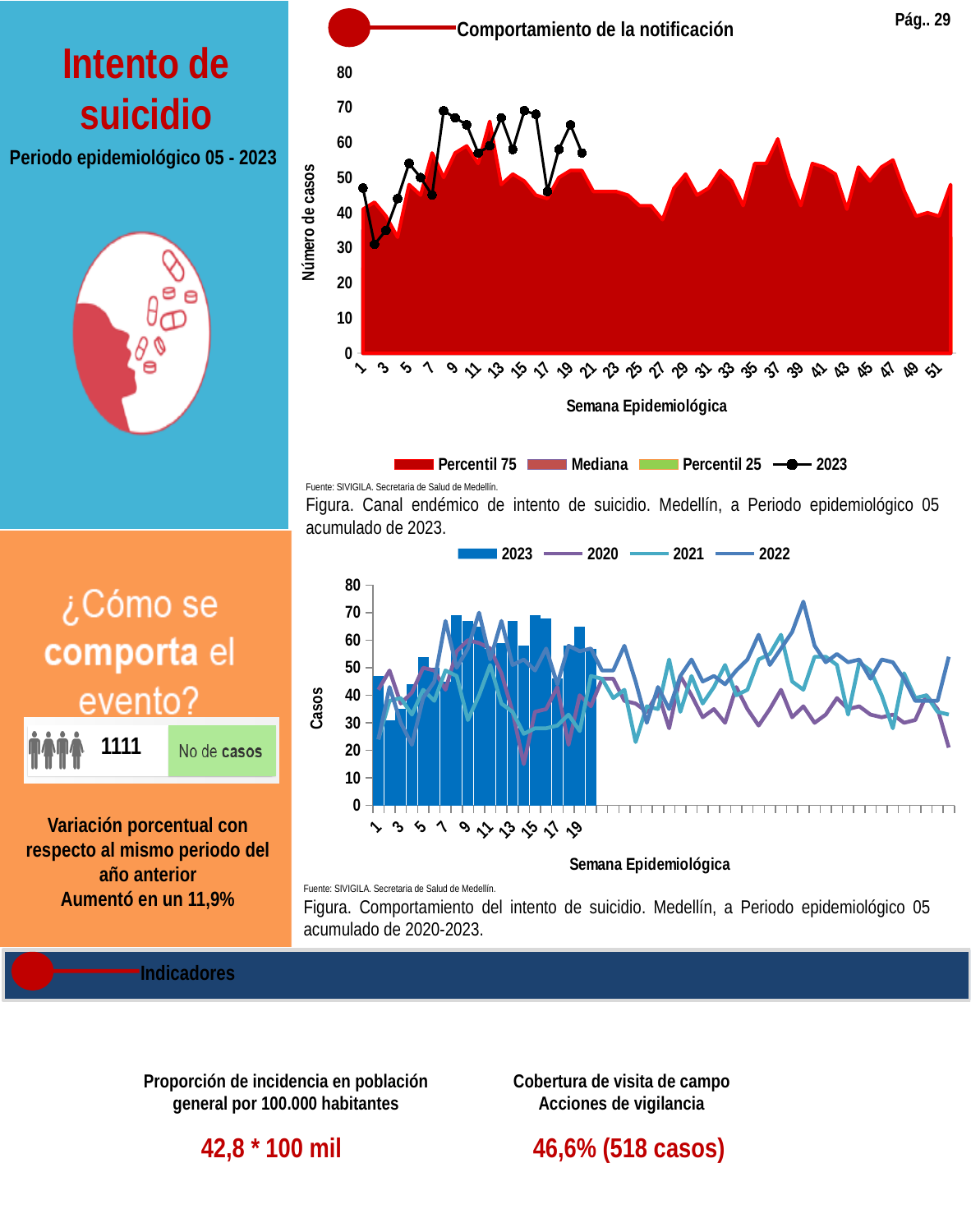
What is the y-axis label of the bottom chart? Casos In the top chart 'Comportamiento de la notificación', is the 2023 value at week 17 greater or less than 50? less In the bottom chart, what kind of chart is used to show the 2023 series? bar chart In the bottom chart, is the 2023 bar at week 8 greater or less than 60? greater In the top chart 'Comportamiento de la notificación', is the 2023 value at week 2 greater or less than 40? less In the bottom chart, how many weeks have a 2023 bar plotted? 20 In the bottom chart, how many series does the legend list? 4 In the top chart 'Comportamiento de la notificación', how many series does the legend list? 4